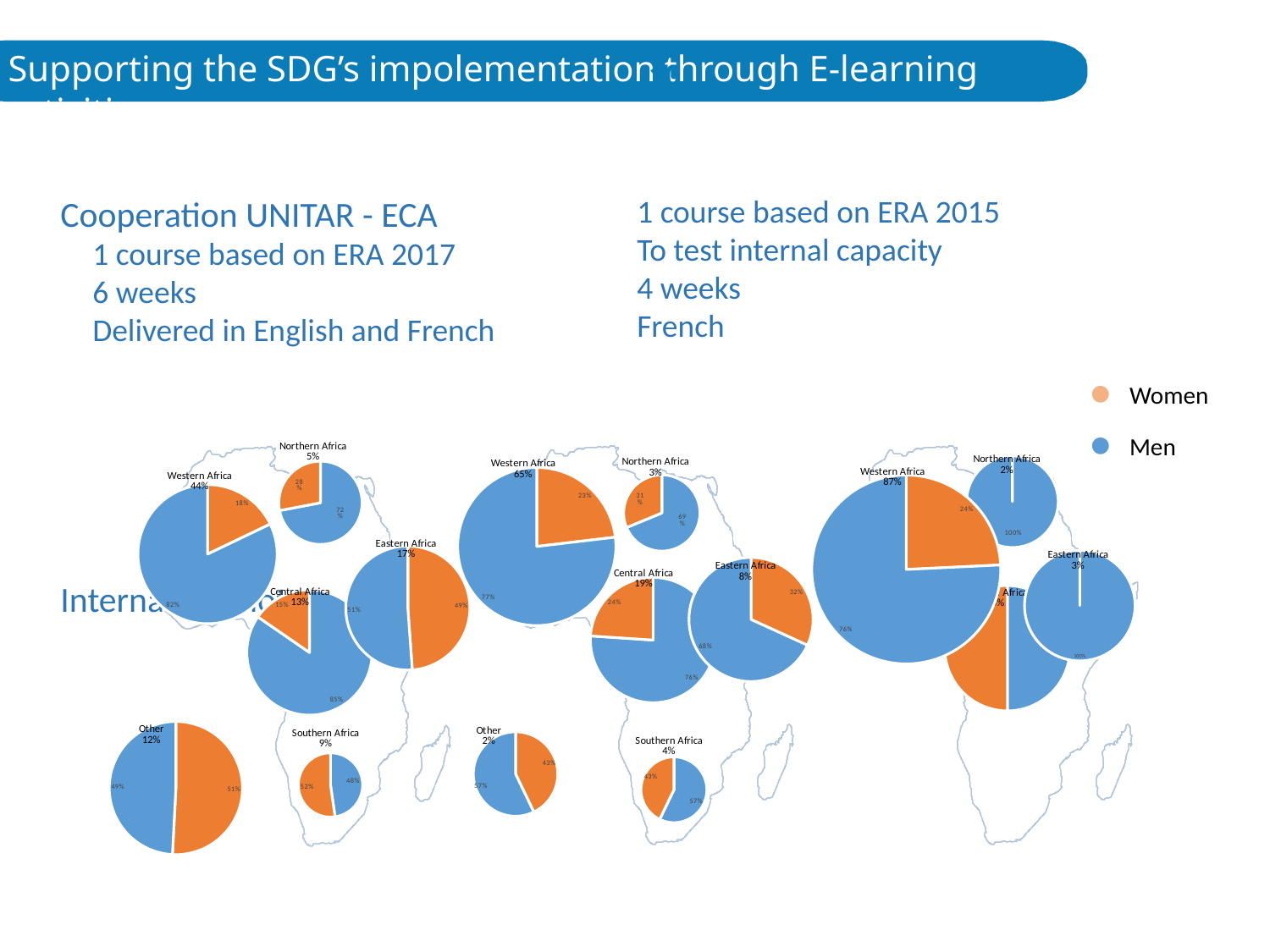
What kind of charts are used on the maps? Pie charts On the middle map, which is larger: the share for Central Africa or the share for Eastern Africa? Central Africa On the right map, what share of participants is shown for Western Africa? 87% On the left map, what is the difference between the Western Africa share (44%) and the Eastern Africa share (17%)? 27% On the left map, what share of participants is shown for Western Africa? 44% On the left map, what share of participants is shown for Northern Africa? 5% On the middle map, which region has the smallest share of participants? Other On the middle map, what share of participants is shown for Western Africa? 65% On the middle map, what share of participants is shown for Central Africa? 19% How many series does the legend list? 2 On the left map, which region has the largest share of participants? Western Africa On the right map, what share of participants is shown for Eastern Africa? 3%